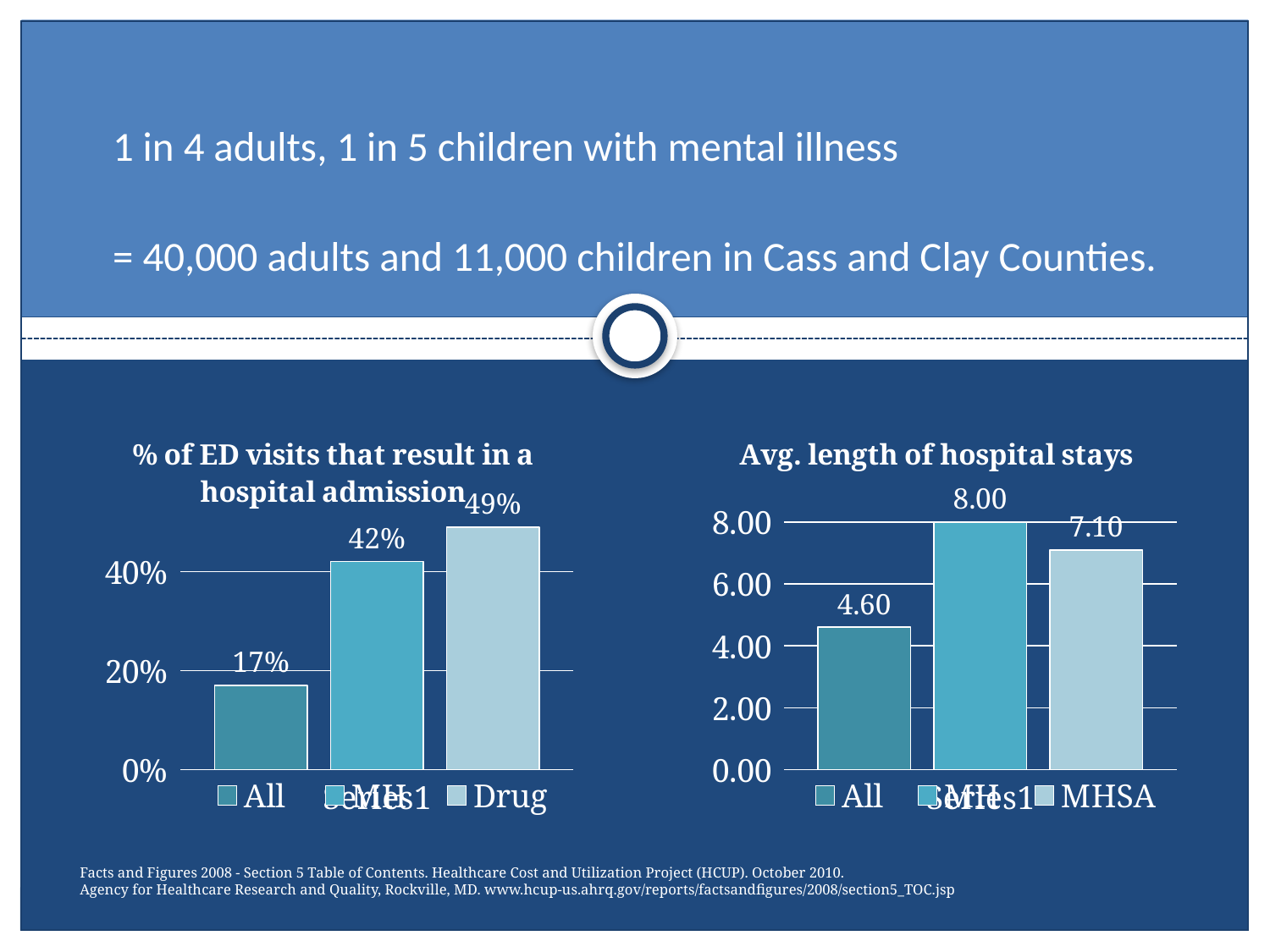
In the 'Avg. length of hospital stays' chart, which is larger, the value for All or the value for MHSA? MHSA In the 'Avg. length of hospital stays' chart, what is the value for MHSA? 7.10 In the '% of ED visits that result in a hospital admission' chart, what is the difference between the Drug value and the All value? 32% In the 'Avg. length of hospital stays' chart, what is the value for All? 4.60 In the 'Avg. length of hospital stays' chart, what is the difference between the MH value and the MHSA value? 0.90 What kind of chart is the 'Avg. length of hospital stays' chart? Bar chart In the '% of ED visits that result in a hospital admission' chart, which category has the lowest value? All In the '% of ED visits that result in a hospital admission' chart, how many bars are plotted? 3 In the '% of ED visits that result in a hospital admission' chart, what is the value for Drug? 49% In the 'Avg. length of hospital stays' chart, which category has the highest value? MH In the '% of ED visits that result in a hospital admission' chart, which category has the highest value? Drug In the '% of ED visits that result in a hospital admission' chart, what is the value for All? 17%